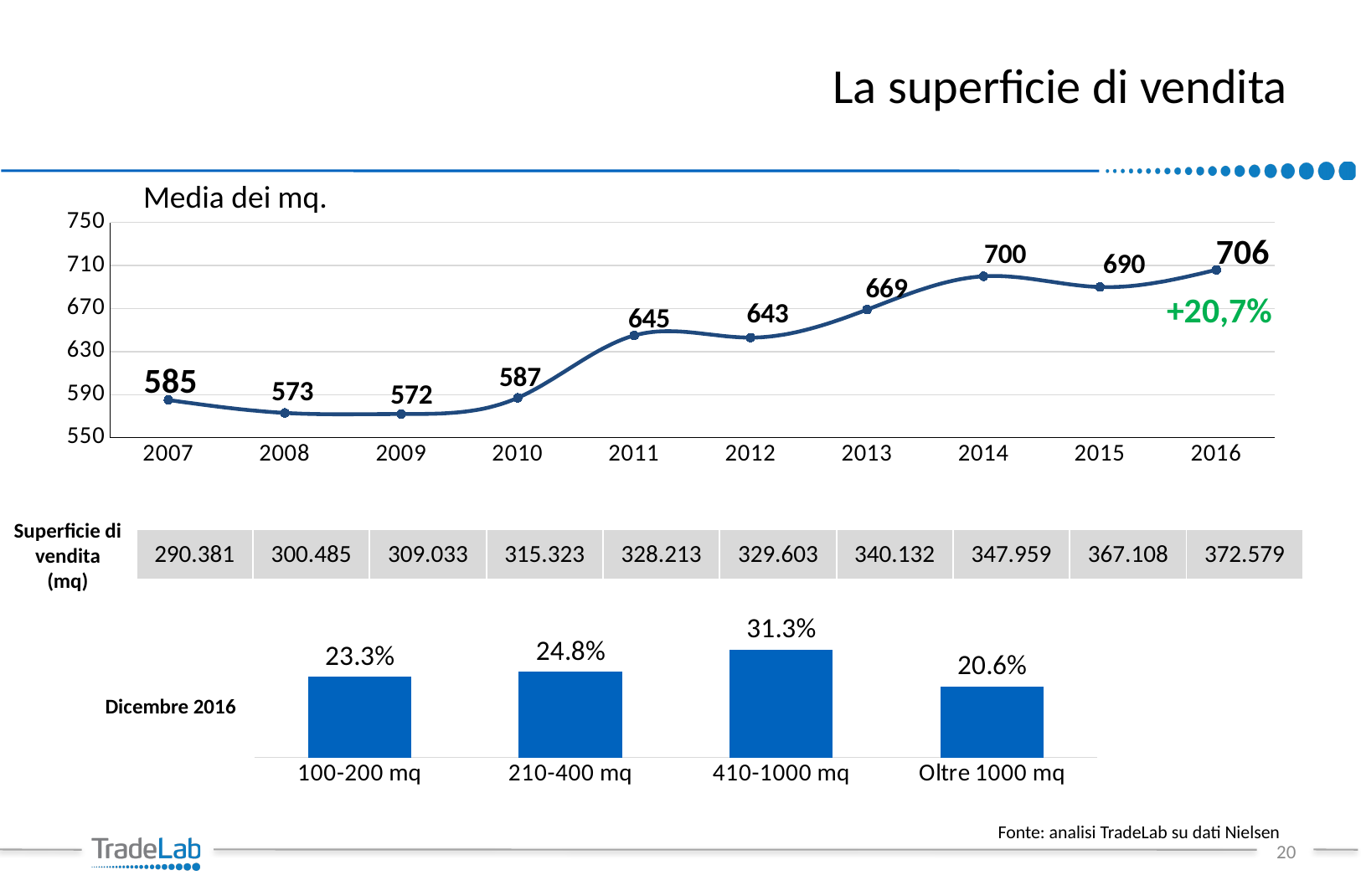
In the 'Media dei mq.' line chart, what is the value for 2011? 645 In the 'Dicembre 2016' bar chart at the bottom of the slide, which category has the lowest value? Oltre 1000 mq In the 'Media dei mq.' line chart, which year has the highest value? 2016 In the 'Media dei mq.' line chart, do the values generally rise or fall from 2007 to 2016? rise What kind of chart is the 'Dicembre 2016' chart at the bottom of the slide? bar chart In the 'Media dei mq.' line chart, what is the difference between the 2016 value and the 2007 value? 121 In the 'Media dei mq.' line chart, which year has the lowest value? 2009 What kind of chart is the 'Media dei mq.' chart at the top of the slide? line chart In the 'Dicembre 2016' bar chart at the bottom of the slide, what is the value for '410-1000 mq'? 31.3% In the 'Media dei mq.' line chart, which is larger, the value for 2014 or the value for 2015? 2014 In the 'Media dei mq.' line chart, how many years are plotted? 10 In the 'Dicembre 2016' bar chart at the bottom of the slide, what is the difference between '410-1000 mq' and '100-200 mq'? 8.0%